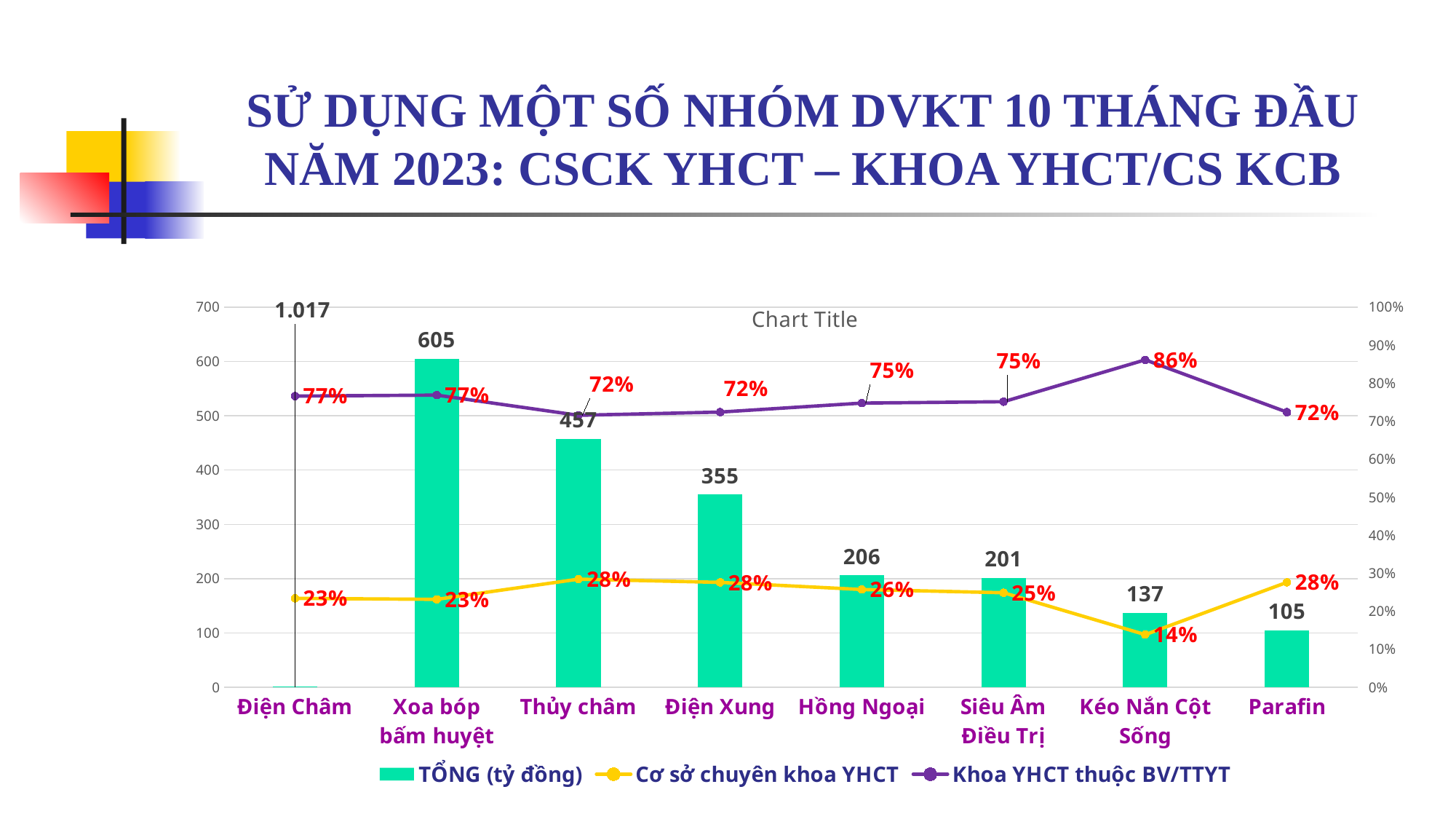
Which category has the lowest TỔNG (tỷ đồng) value? Parafin What kind of chart is this? Combined bar and line chart What is the TỔNG (tỷ đồng) value for Xoa bóp bấm huyệt? 605 What is the Khoa YHCT thuộc BV/TTYT percentage for Kéo Nắn Cột Sống? 86% Which category has the highest TỔNG (tỷ đồng) value? Điện Châm How many categories are shown on the x axis? 8 What colour are the TỔNG (tỷ đồng) bars? Green What is the difference between the TỔNG (tỷ đồng) values for Xoa bóp bấm huyệt and Thủy châm? 148 How many series does the legend list? 3 Which category has the lowest Cơ sở chuyên khoa YHCT percentage? Kéo Nắn Cột Sống What is the Cơ sở chuyên khoa YHCT percentage for Hồng Ngoại? 26% Which has a larger TỔNG (tỷ đồng) value, Hồng Ngoại or Siêu Âm Điều Trị? Hồng Ngoại